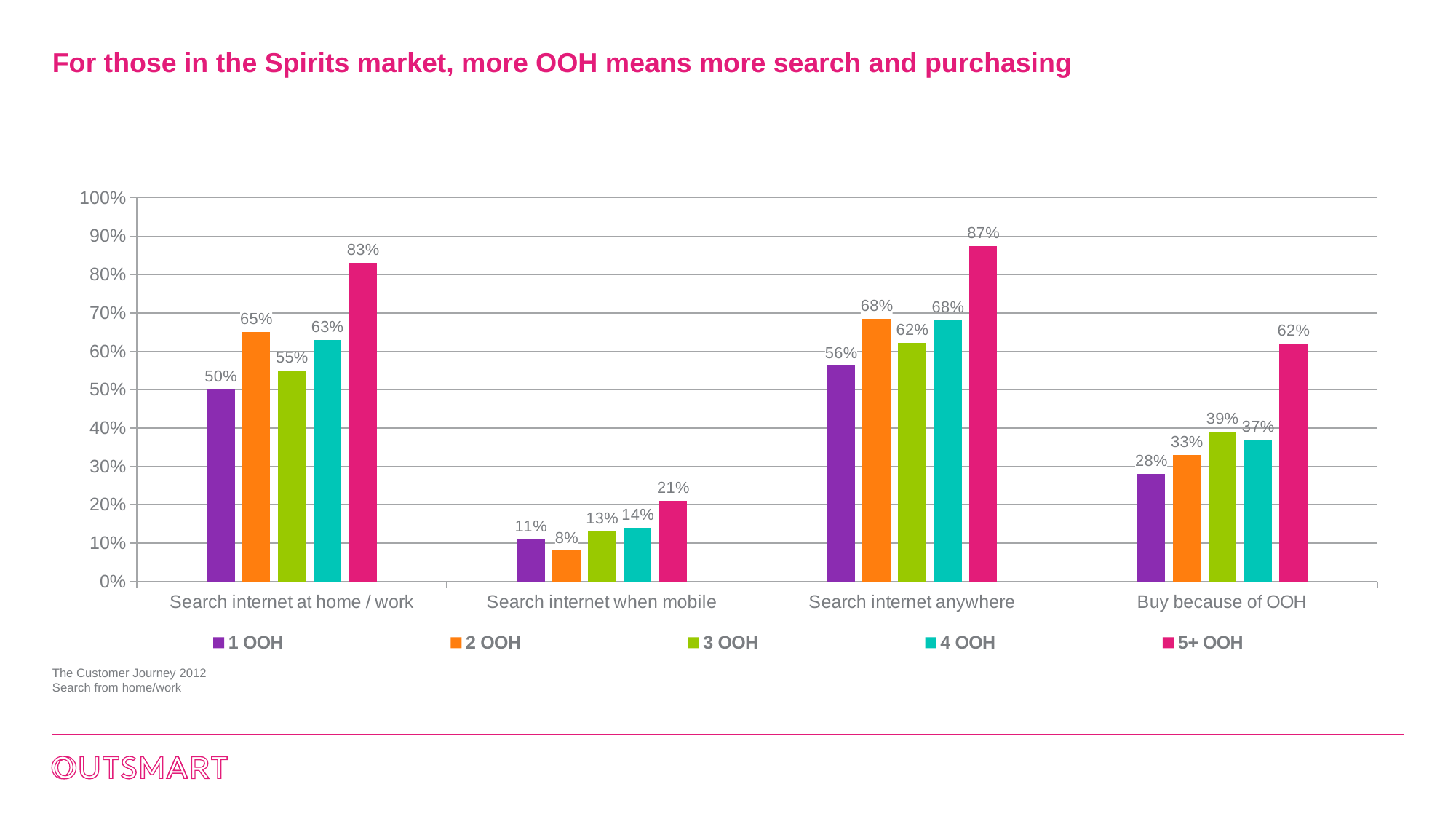
What is the difference between the 5+ OOH and 1 OOH values in the 'Search internet at home / work' category? 33% Which series has the highest value in the 'Search internet anywhere' category? 5+ OOH How many categories are shown on the x axis? 4 What is the difference between the 5+ OOH and 4 OOH values in the 'Buy because of OOH' category? 25% What colour represents the 5+ OOH series in the legend? Pink Which series has the lowest value in the 'Search internet when mobile' category? 2 OOH Which is larger in the 'Buy because of OOH' category: 3 OOH or 2 OOH? 3 OOH How many series does the legend list? 5 What is the value for 5+ OOH in the 'Search internet at home / work' category? 83% What kind of chart is shown on the slide? Bar chart What is the value for 2 OOH in the 'Search internet when mobile' category? 8% What is the value for 1 OOH in the 'Buy because of OOH' category? 28%